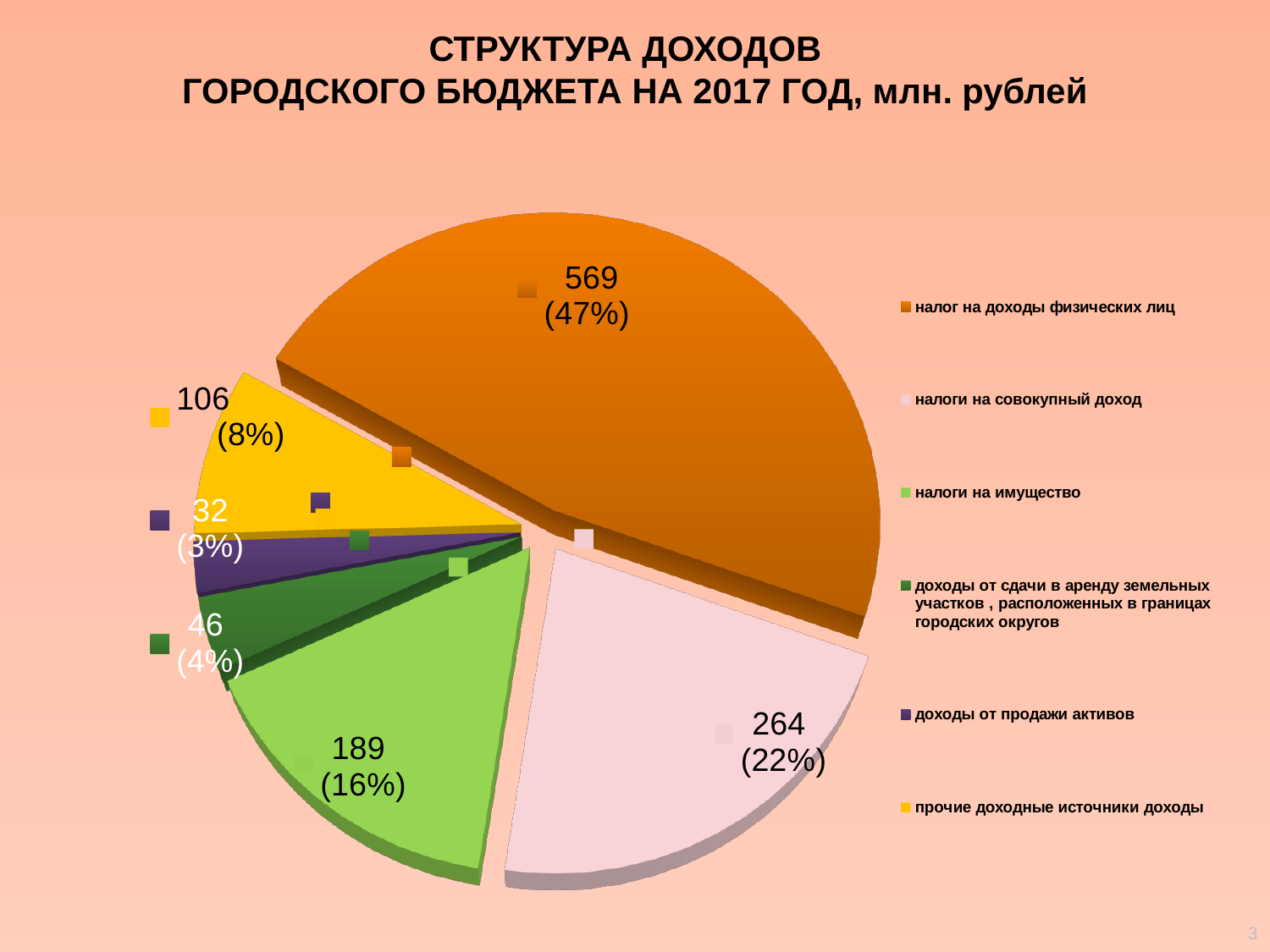
What is the difference between the values for налог на доходы физических лиц and налоги на совокупный доход? 305 What share of the pie does налоги на имущество represent? 16% What kind of chart is shown on the slide? pie chart Which category has the smallest slice of the pie? доходы от продажи активов Which is larger: the value for прочие доходные источники доходы or the value for доходы от сдачи в аренду земельных участков? прочие доходные источники доходы What is the value for налог на доходы физических лиц? 569 Which category has the largest slice of the pie? налог на доходы физических лиц What is the value for прочие доходные источники доходы? 106 What is the value for доходы от продажи активов? 32 What is the value for налоги на совокупный доход? 264 How many categories does the legend list? 6 What is the value for налоги на имущество? 189